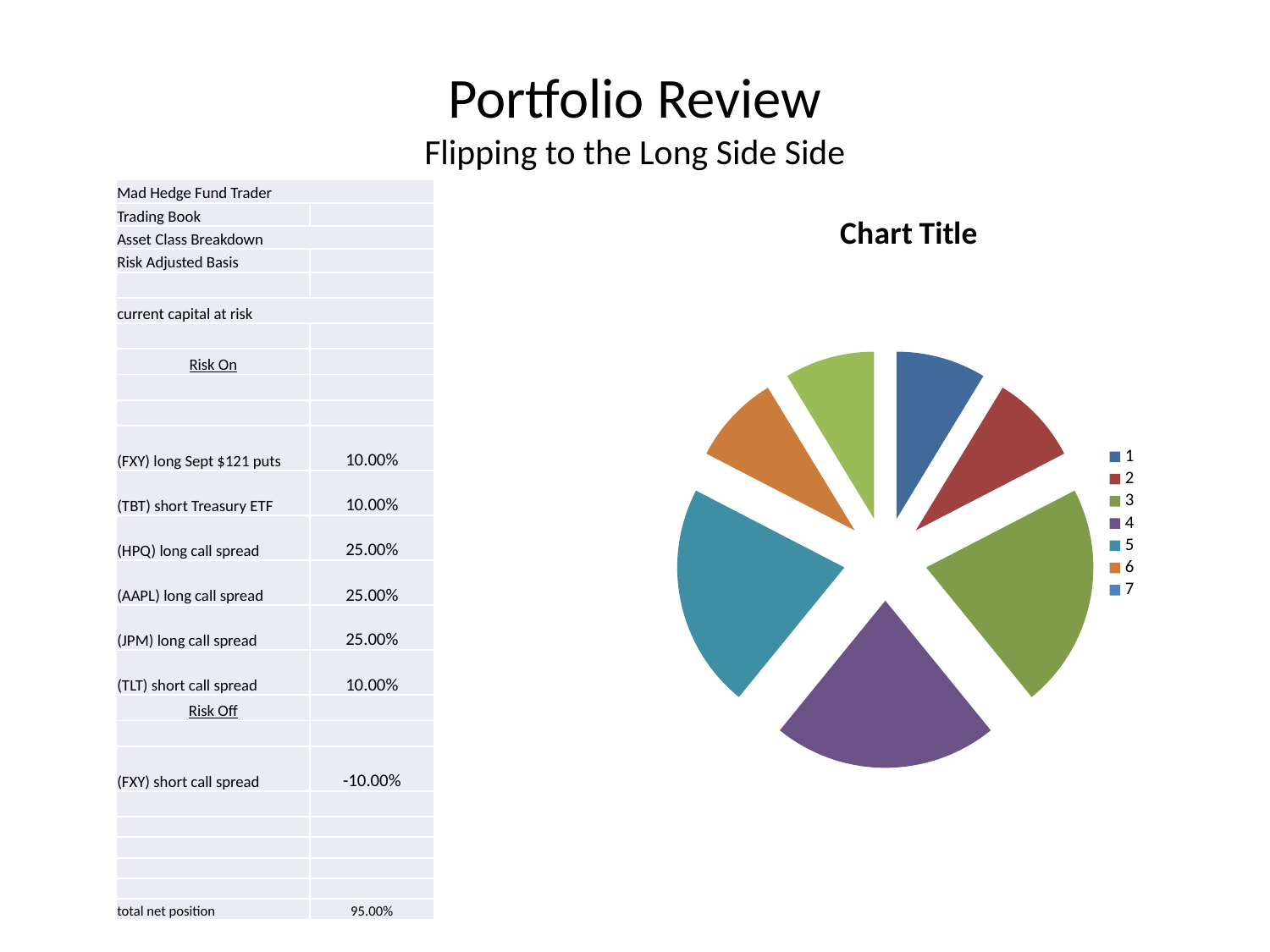
Which is larger in the pie chart, slice 7 or slice 4? 4 Which is larger in the pie chart, slice 3 or slice 1? 3 How many entries does the chart's legend list? 7 What is the title of the chart on the slide? Chart Title How many slices does the pie chart have? 7 What kind of chart is shown on the slide? pie chart Which is larger in the pie chart, slice 5 or slice 6? 5 What colour is slice 4 in the pie chart? purple